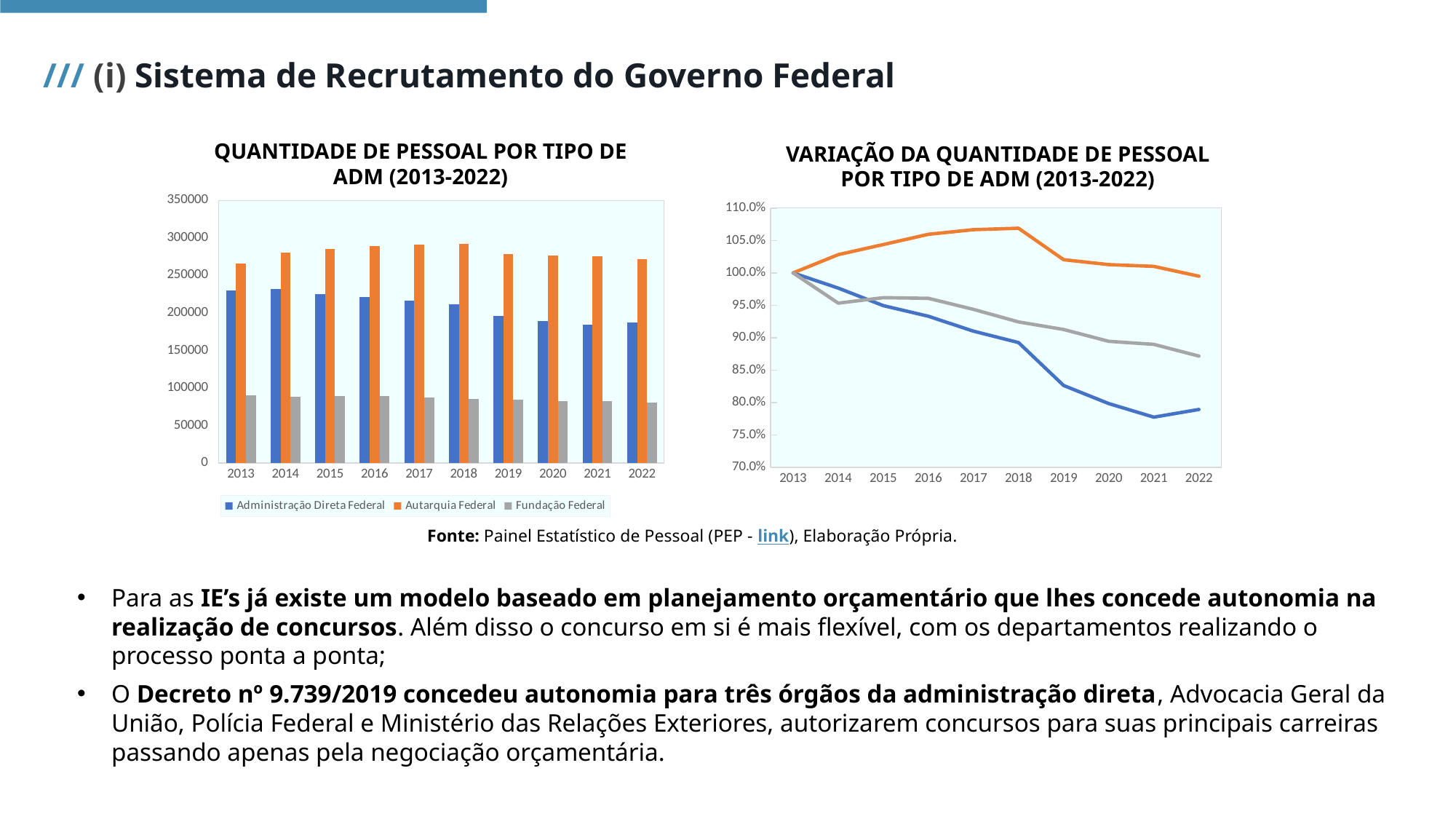
In the left chart, which series has the lowest value in 2022? Fundação Federal What kind of chart is the left chart titled 'QUANTIDADE DE PESSOAL POR TIPO DE ADM (2013-2022)'? Bar chart In the left chart, is the value for Autarquia Federal in 2013 greater or less than 250000? greater In the left chart, how many years are shown on the x axis? 10 In the left chart, how many series does the legend list? 3 What kind of chart is the right chart titled 'VARIAÇÃO DA QUANTIDADE DE PESSOAL POR TIPO DE ADM (2013-2022)'? Line chart In the left chart, is the value for Fundação Federal in 2013 greater or less than 100000? less In the right chart, is the value of the orange line in 2018 greater or less than 105.0%? greater In the left chart, which is larger in 2018: Administração Direta Federal or Autarquia Federal? Autarquia Federal In the left chart, which series has the highest value in 2013? Autarquia Federal In the right chart, does the blue line rise or fall from 2013 to 2022? Fall